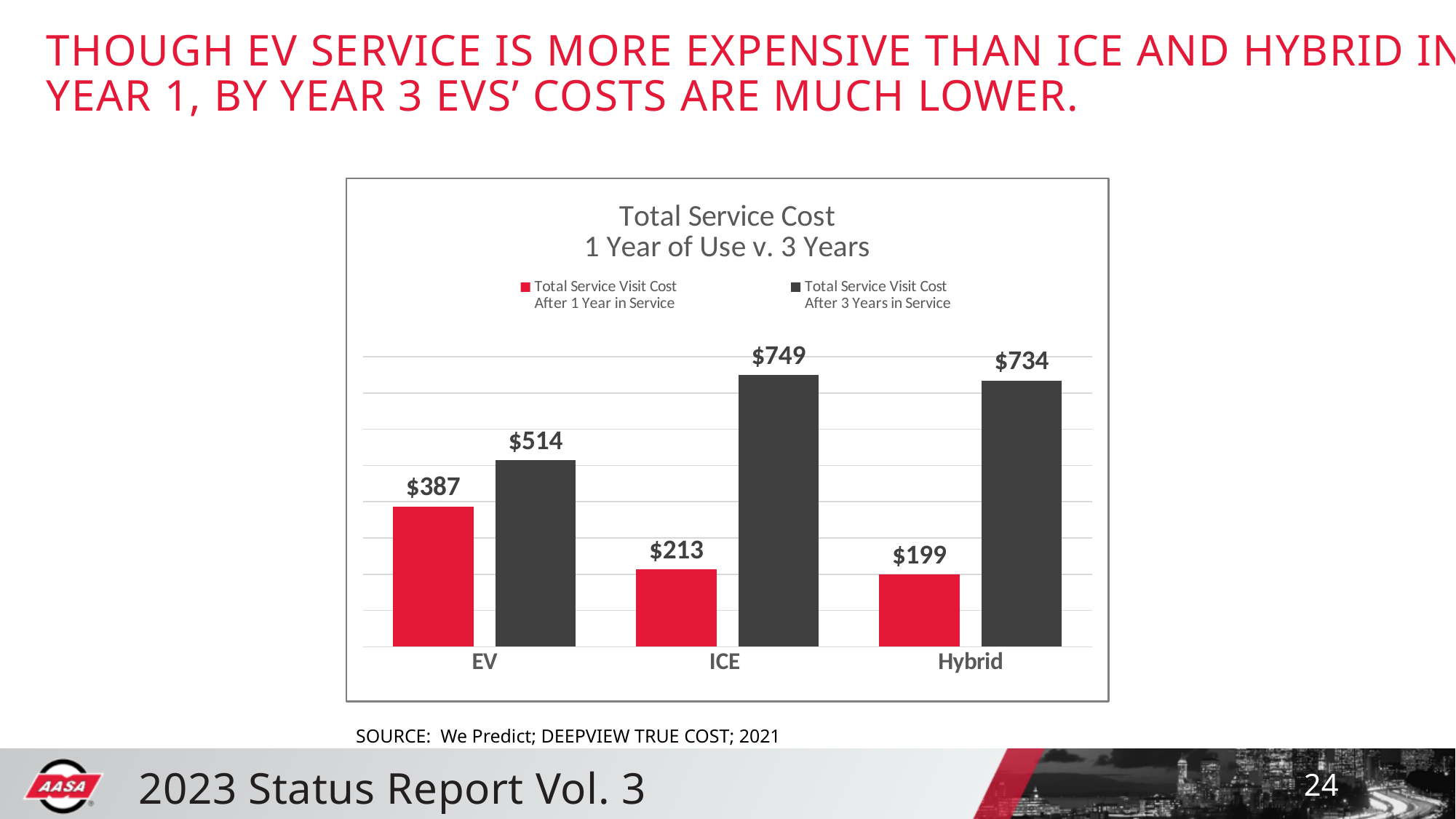
What type of chart is shown on the slide? Bar chart What is the Total Service Visit Cost After 1 Year in Service for Hybrid? $199 Which vehicle type has the highest Total Service Visit Cost After 3 Years in Service? ICE What is the Total Service Visit Cost After 3 Years in Service for EV? $514 Which is larger: the Hybrid cost after 3 years or the EV cost after 3 years? Hybrid What is the Total Service Visit Cost After 3 Years in Service for ICE? $749 What is the difference between the ICE and EV Total Service Visit Cost After 3 Years in Service? $235 What is the difference between the EV and ICE Total Service Visit Cost After 1 Year in Service? $174 What is the Total Service Visit Cost After 1 Year in Service for EV? $387 Which vehicle type has the lowest Total Service Visit Cost After 1 Year in Service? Hybrid How many series does the chart legend list? 2 How many vehicle types are shown on the x axis of the chart? 3